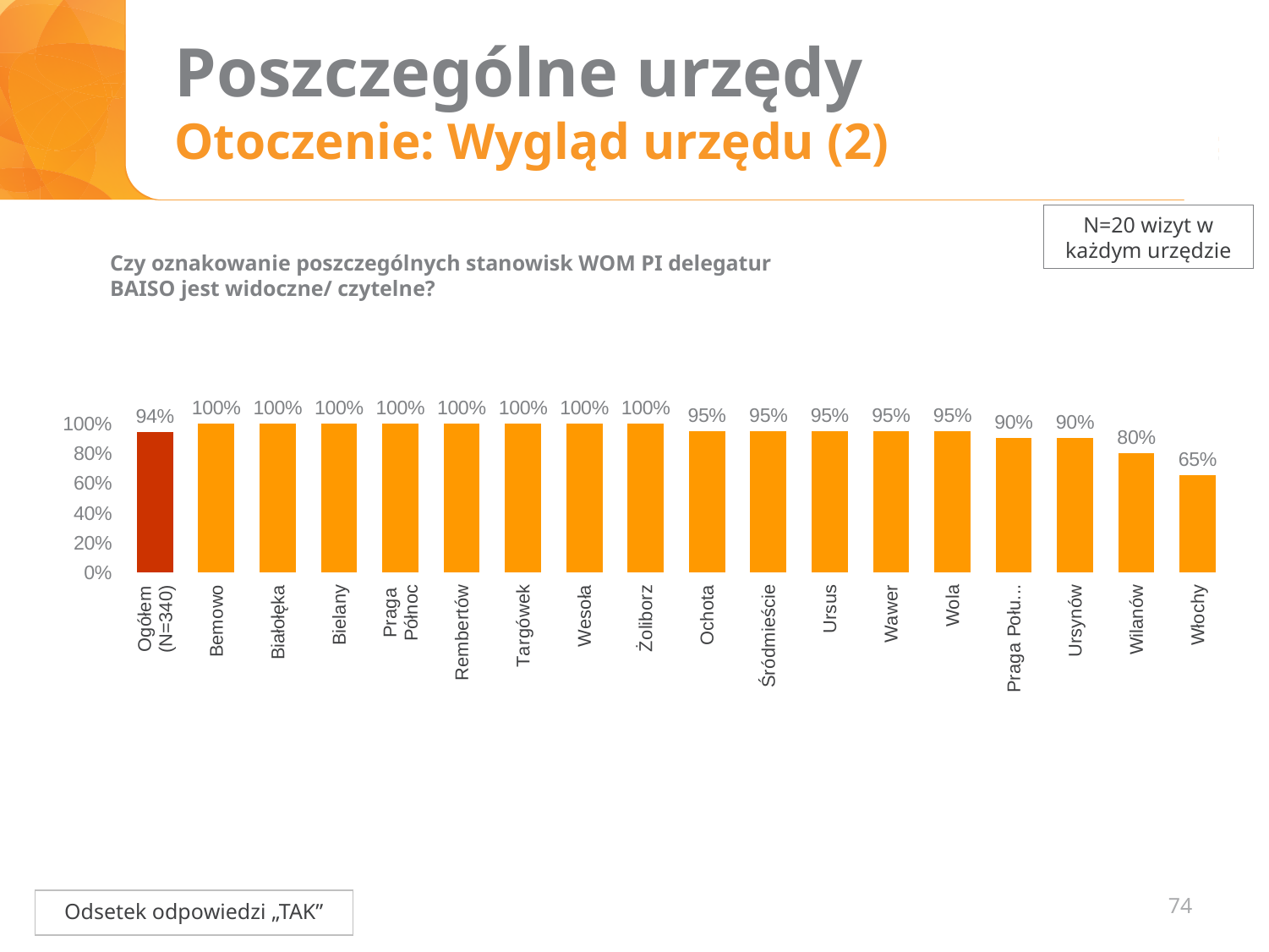
Which category has the lowest value? Włochy What kind of chart is shown on the slide? Bar chart What is the value for Ochota? 95% What is the value for Wilanów? 80% What is the difference between the values for Bemowo and Ogółem (N=340)? 6% What is the value for Ogółem (N=340)? 94% How many bars are shown in the chart? 18 What is the value for Ursynów? 90% What is the difference between the values for Wilanów and Włochy? 15% Which is larger, the value for Wola or the value for Ursynów? Wola What is the value for Włochy? 65% Which bar is shown in a different (dark red) colour from the others? Ogółem (N=340)